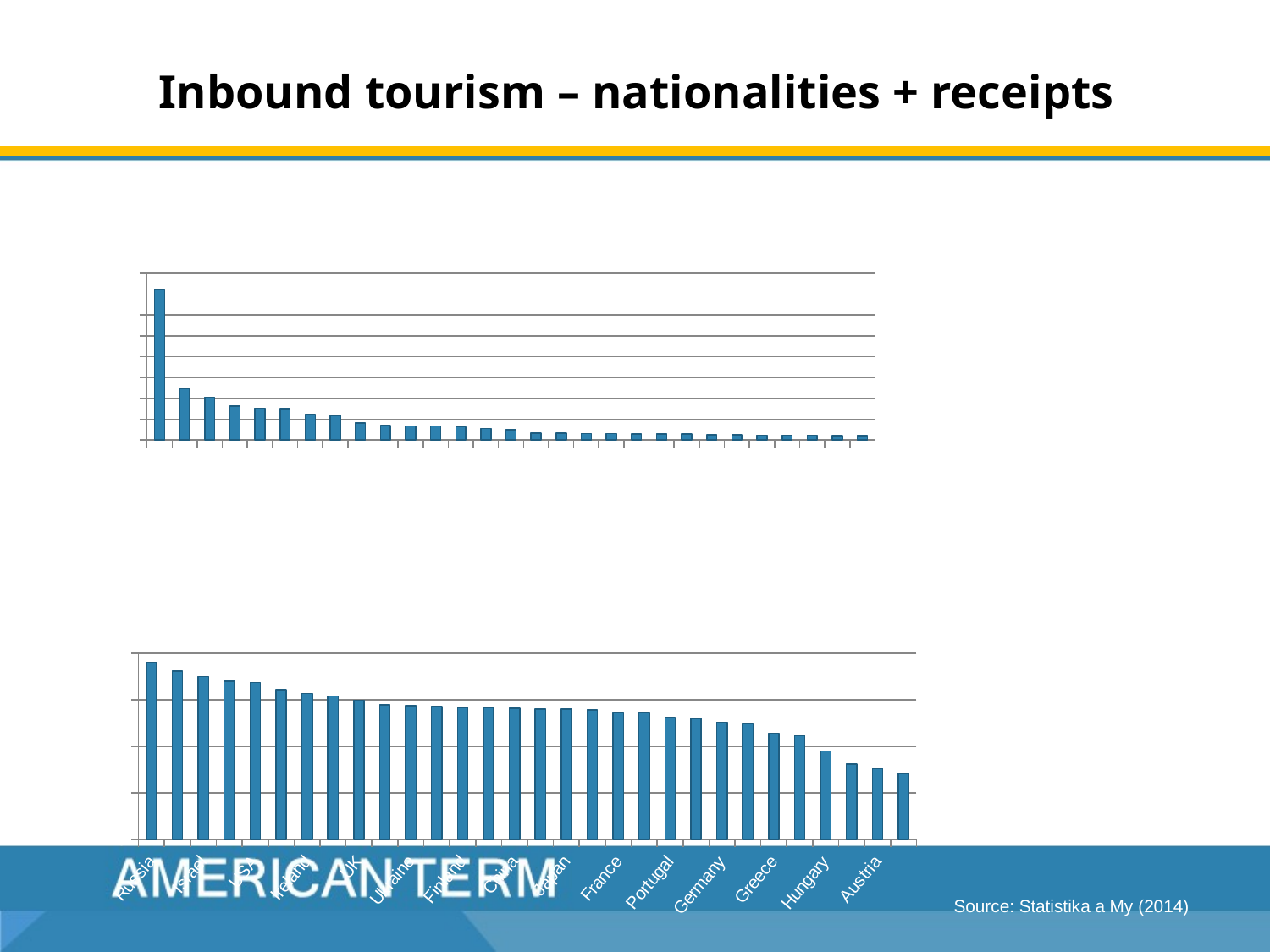
In the top chart, do the values rise or fall from left to right along the x axis? fall In the top chart, is the first (leftmost) bar the highest or the lowest bar? highest What kind of chart is the bottom chart on the slide? bar chart In the bottom chart, which is larger, the value for Russia or the value for Austria? Russia What colour are the bars in the bottom chart? blue In the bottom chart, which is larger, the value for Israel or the value for Greece? Israel In the bottom chart, which labelled country has the highest value? Russia In the bottom chart, which labelled country has the lowest value? Austria In the bottom chart, do the values rise or fall from left to right along the x axis? fall In the bottom chart, which is larger, the value for France or the value for Hungary? France What kind of chart is the top chart on the slide? bar chart